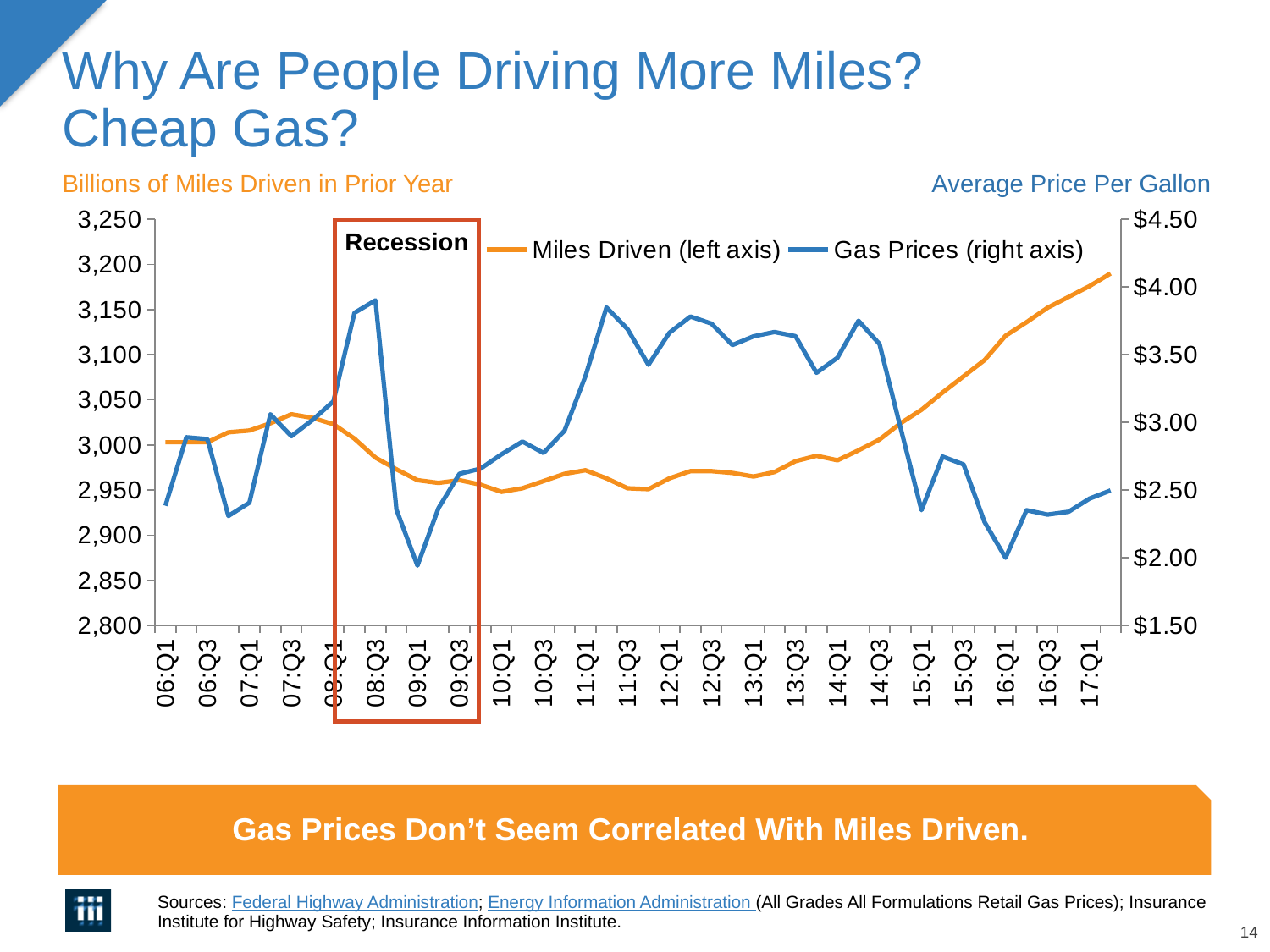
What label is shown in the red box on the chart? Recession How many series does the chart's legend list? 2 Is the Gas Prices value at 15:Q1 greater or less than $2.50? less Is the Gas Prices value at 08:Q3 greater or less than $3.50? greater Is the Miles Driven value at 09:Q3 greater or less than 3,000? less Which is larger, the Gas Prices value at 12:Q1 or at 16:Q1? 12:Q1 Which series is plotted against the right axis? Gas Prices What kind of chart is shown on the slide? Line chart Does the Gas Prices series rise or fall from 14:Q3 to 15:Q1? Fall Does the Miles Driven series rise or fall from 14:Q1 to 17:Q1? Rise